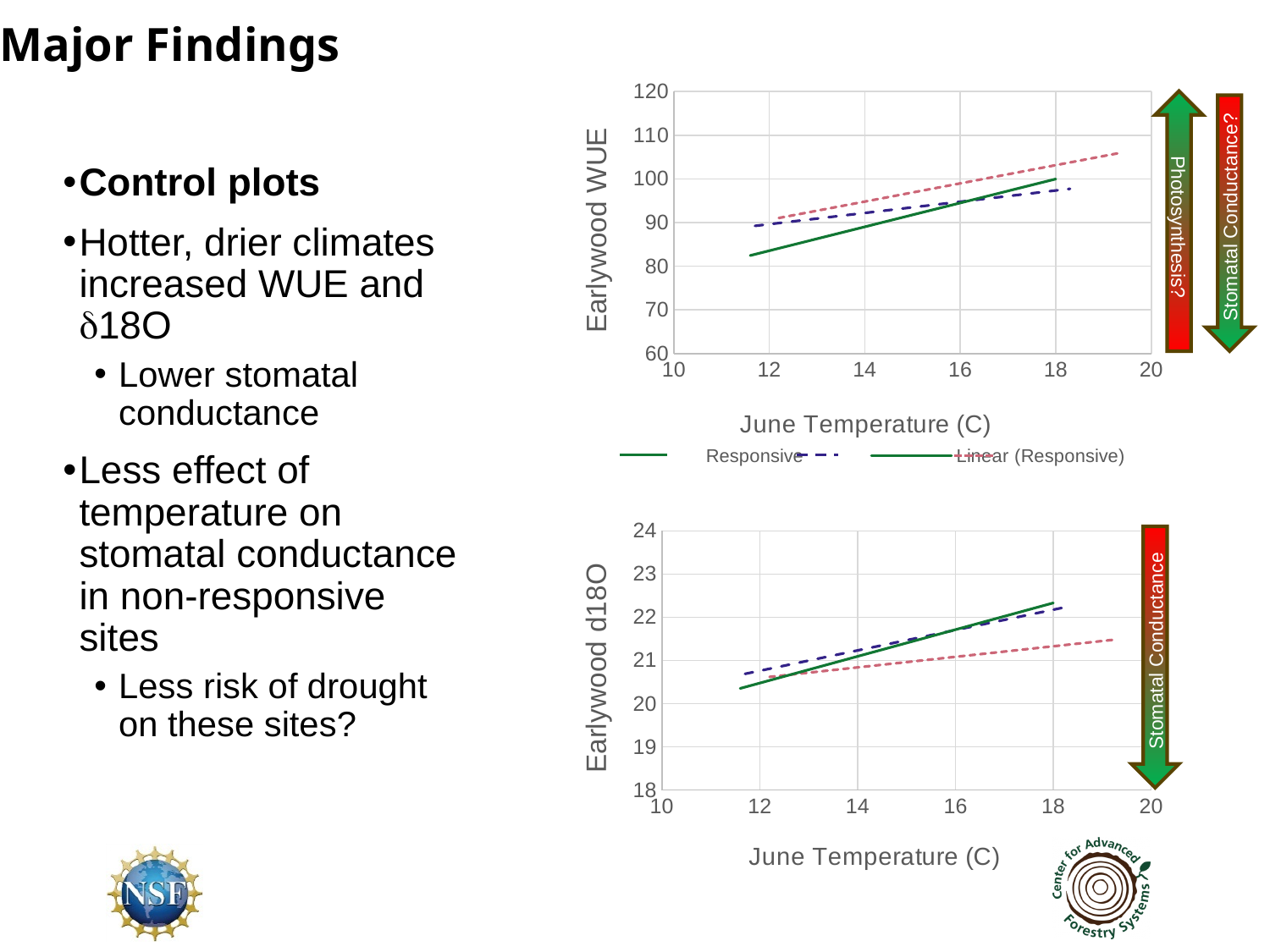
In the top chart (Earlywood WUE), at a June Temperature of 12, which line is higher: the pink dashed line or the solid green line? the pink dashed line In the top chart (Earlywood WUE), is the value of the solid green line at a June Temperature of 18 greater or less than 90? greater What is the x-axis label of the top chart? June Temperature (C) What is the y-axis label of the bottom chart? Earlywood d18O In the top chart (Earlywood WUE), is the value of the solid green line at a June Temperature of 12 greater or less than 90? less In the bottom chart (Earlywood d18O), at a June Temperature of 18, which line is higher: the solid green line or the pink dashed line? the solid green line In the bottom chart (Earlywood d18O), is the value of the pink dashed line at a June Temperature of 18 greater or less than 22? less What kind of chart is the top chart on the slide? line chart In the bottom chart (Earlywood d18O), do the plotted lines rise or fall as June Temperature increases? rise How many lines are plotted in the bottom chart (Earlywood d18O)? 3 In the top chart (Earlywood WUE), do the plotted lines rise or fall as June Temperature increases? rise